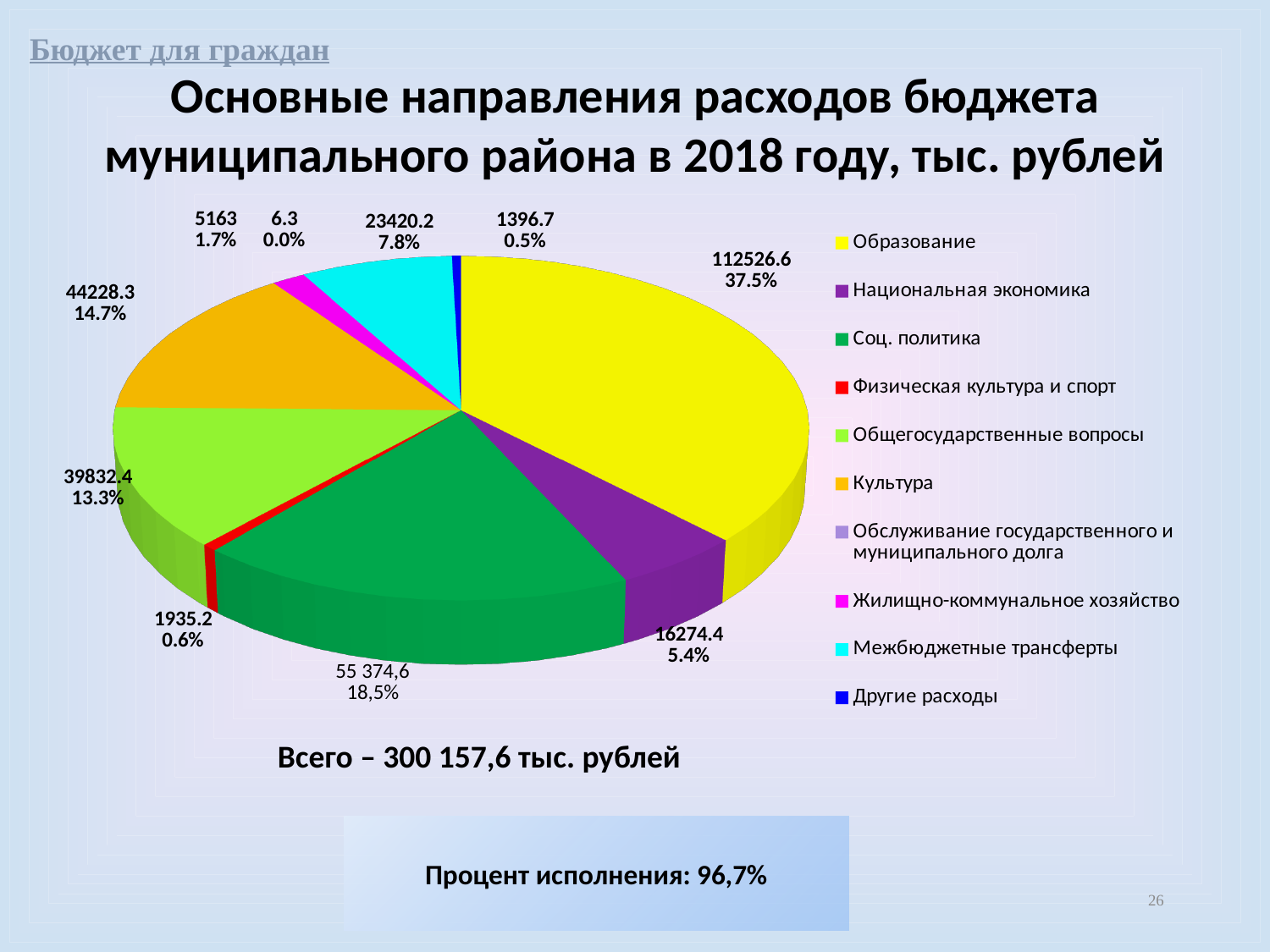
What total is stated below the pie chart? 300 157,6 тыс. рублей Which category has the smallest value in the pie chart? Обслуживание государственного и муниципального долга What is the value shown for Культура? 44228.3 What is the value shown for Физическая культура и спорт? 1935.2 What percentage is shown for Межбюджетные трансферты? 7.8% How many categories does the legend of the pie chart list? 10 What type of chart is shown on the slide? Pie chart Which category has the largest slice of the pie? Образование What is the difference between the value for Культура (44228.3) and the value for Общегосударственные вопросы (39832.4)? 4395.9 Which is larger, the value for Культура or the value for Общегосударственные вопросы? Культура What share of the pie does Образование represent? 37.5% What is the value shown for Образование? 112526.6